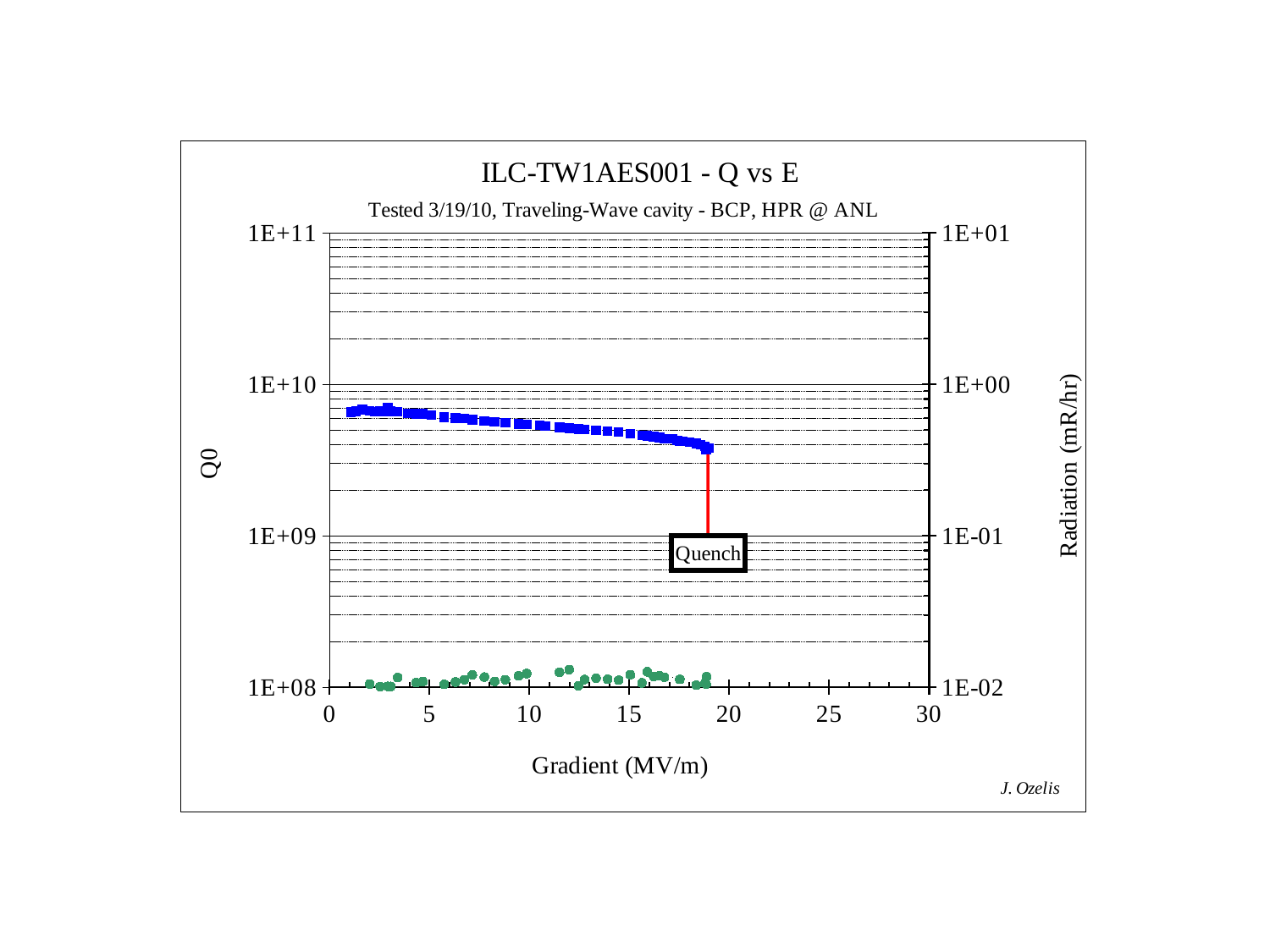
As the gradient increases from 0 to about 19 MV/m, does the Q0 series rise or fall? fall What is the highest tick value shown on the x axis? 30 What kind of chart is shown on the slide? scatter chart Is the Q0 value at a gradient of 15 MV/m greater or less than 1E+10? less What is the title of the chart? ILC-TW1AES001 - Q vs E Is the Q0 value at a gradient of 5 MV/m greater or less than 1E+09? greater What is the label of the x axis? Gradient (MV/m) Is the radiation value at a gradient of 10 MV/m greater or less than 1E-01 mR/hr? less Is the Q0 value at a gradient of 2 MV/m larger or smaller than the Q0 value at a gradient of 18 MV/m? larger